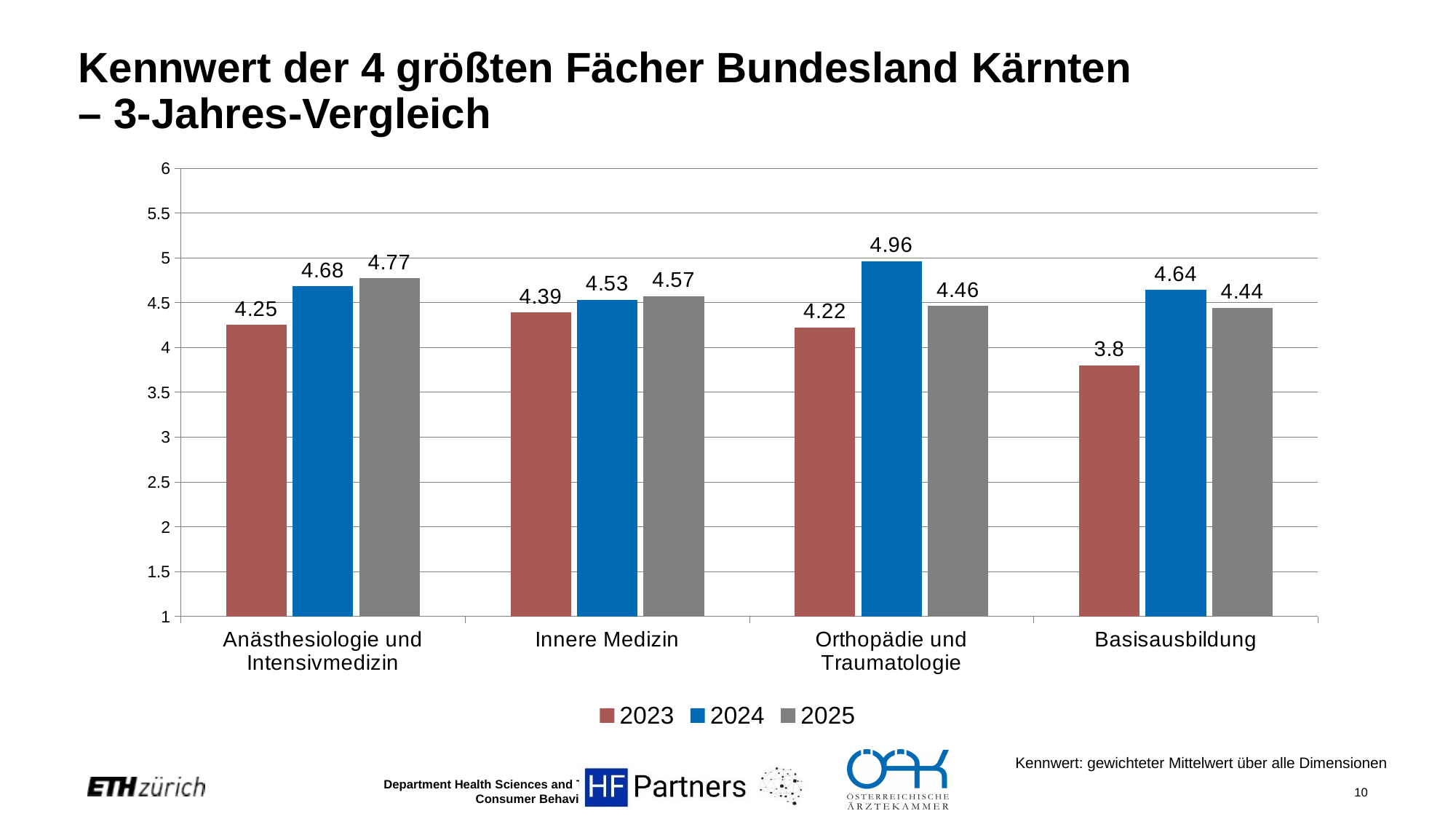
How many categories are shown on the x axis? 4 Do the values for Innere Medizin rise or fall from 2023 to 2025? rise What is the value for Basisausbildung in 2023? 3.8 Which is larger for Innere Medizin: the 2023 value or the 2025 value? 2025 Is the 2023 value for Basisausbildung greater or less than 4? less Which category has the lowest value in 2023? Basisausbildung How many series does the legend list? 3 What is the value for Orthopädie und Traumatologie in 2024? 4.96 Which category has the highest value in 2024? Orthopädie und Traumatologie What kind of chart is shown on the slide? bar chart What is the difference between the 2024 and 2025 values for Orthopädie und Traumatologie? 0.5 What is the value for Anästhesiologie und Intensivmedizin in 2025? 4.77